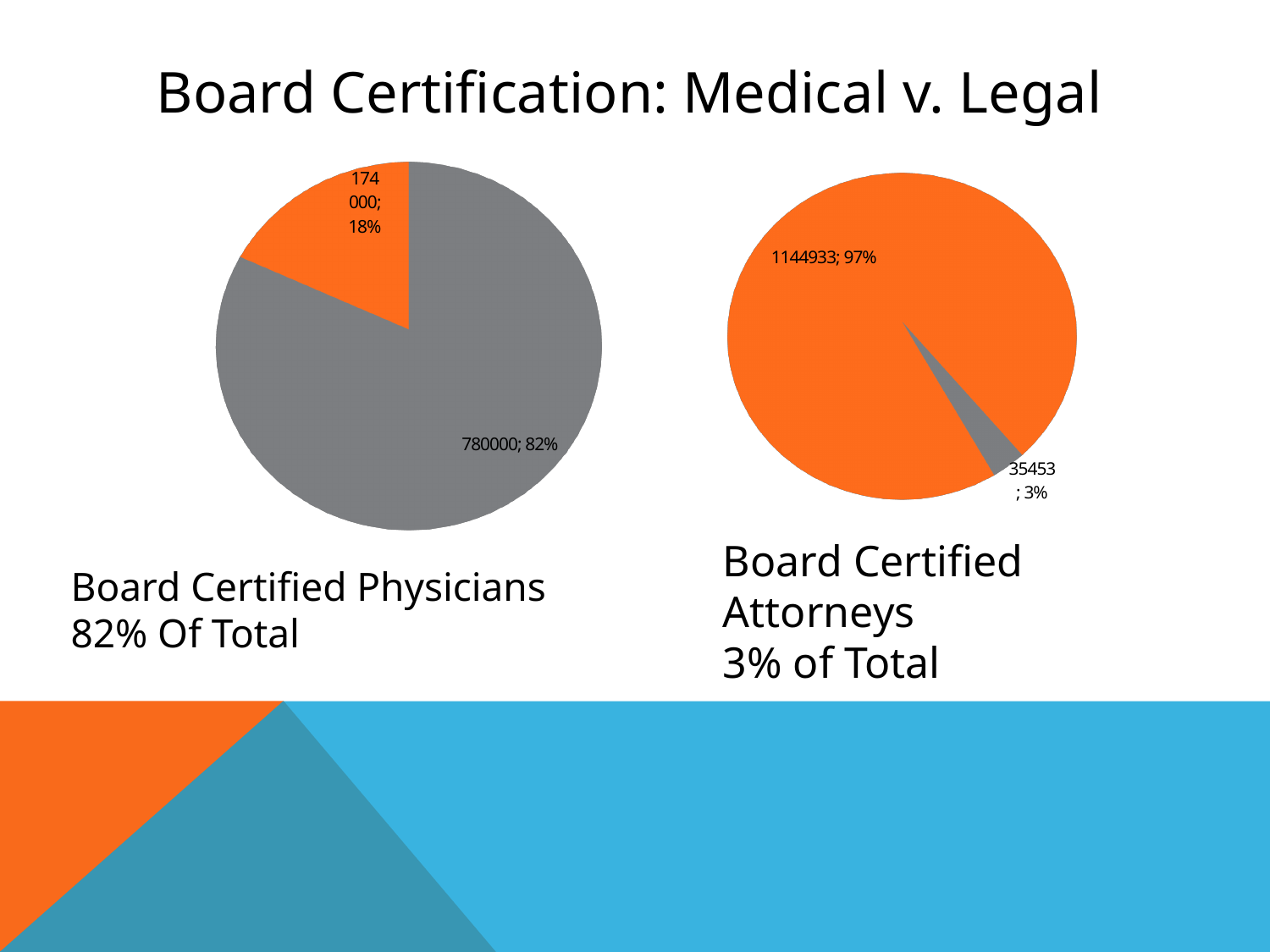
In the right pie chart (attorneys), what percentage share does the gray slice have? 3% In the right pie chart (attorneys), what value is shown for the orange slice? 1144933 How many slices does each pie chart have? 2 In the left pie chart (physicians), what percentage share does the gray slice have? 82% In the right pie chart (attorneys), what is the difference between the orange slice value and the gray slice value? 1109480 In the left pie chart (physicians), what percentage share does the orange slice have? 18% What type of charts are shown on the slide? Pie charts How many pie charts are on the slide? 2 In the right pie chart (attorneys), what is the total of the two slice values? 1180386 In the left pie chart (physicians), what value is shown for the gray slice? 780000 Which chart has the larger gray slice share, the left (physicians) or the right (attorneys)? Left (physicians) In the right pie chart (attorneys), what value is shown for the gray slice? 35453